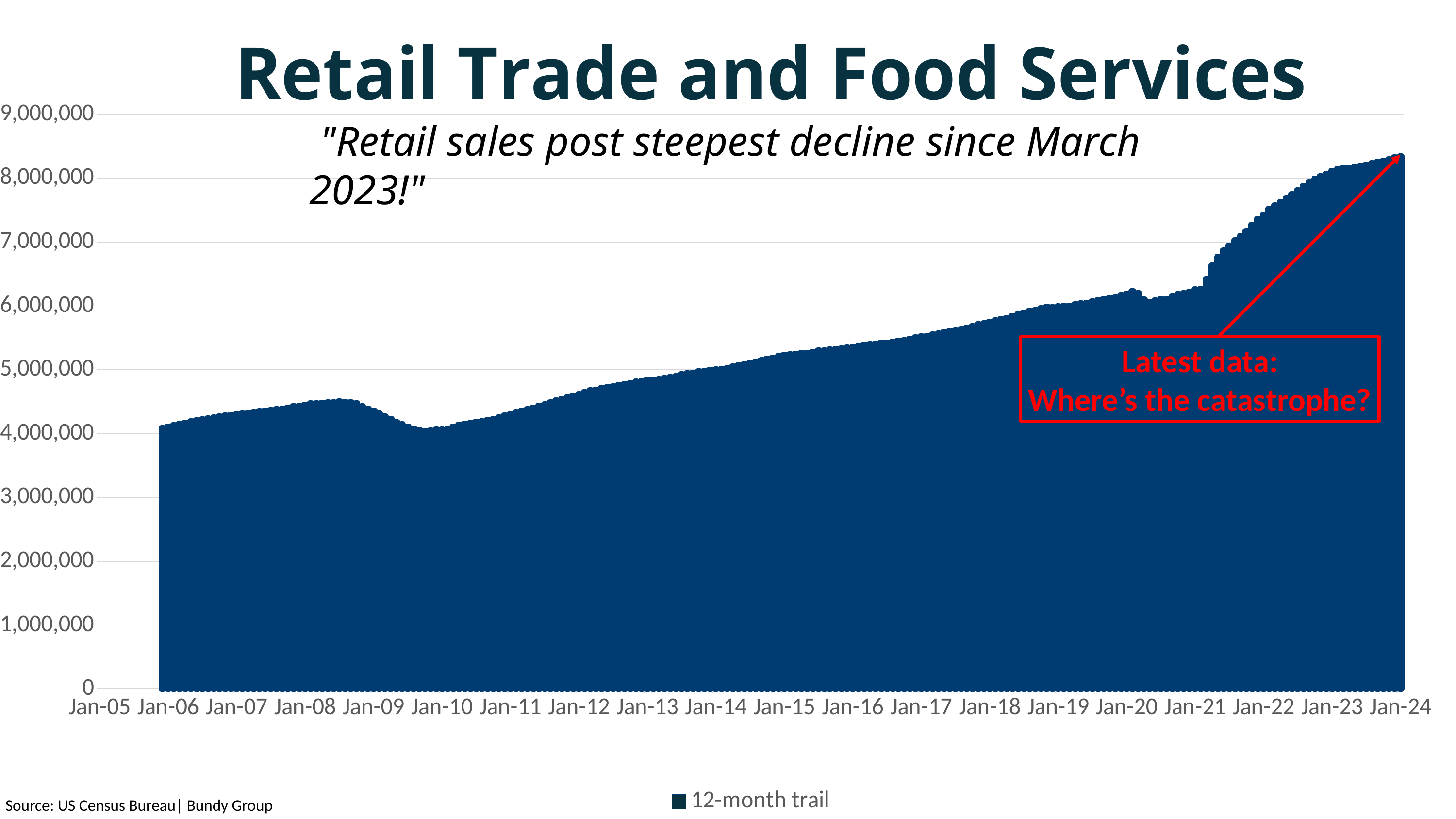
What kind of chart is shown on the slide? Bar chart Is the value at Jan-24 greater or less than 8,000,000? greater At which x-axis date is the value highest? Jan-24 What is the title of the chart? Retail Trade and Food Services How many series does the legend list? 1 Is the value at Jan-12 greater or less than 5,000,000? less Do the values generally rise or fall from Jan-06 to Jan-24? Rise Is the value at Jan-22 greater or less than 7,000,000? greater Which is larger, the value at Jan-09 or the value at Jan-10? Jan-09 What series name is shown in the legend? 12-month trail